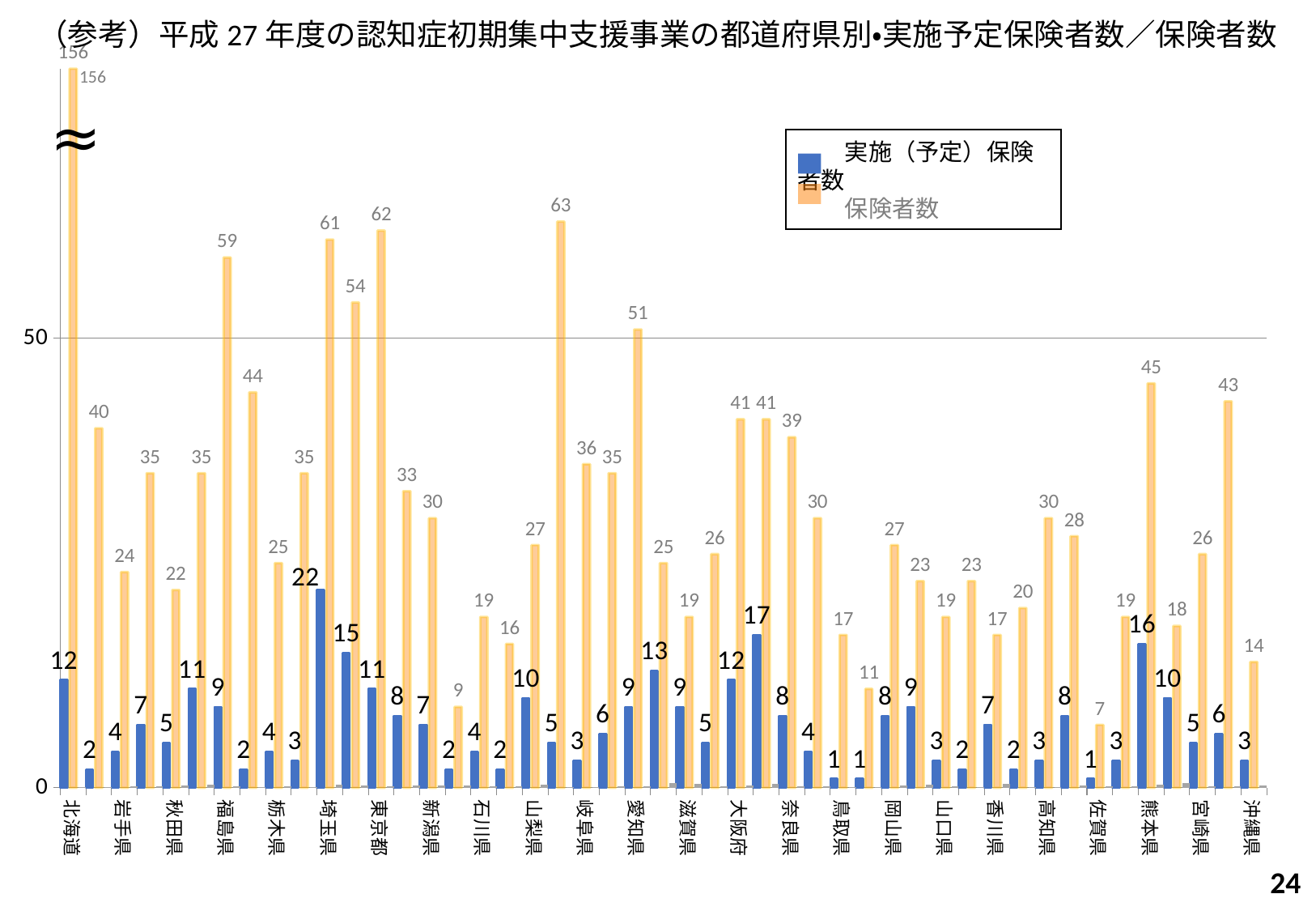
Which prefecture has the highest 実施（予定）保険者数? 埼玉県 Which has the larger 保険者数, 福島県 or 奈良県? 福島県 How many series does the legend list? 2 What kind of chart is shown on the slide? bar chart Which prefecture has the lowest 保険者数? 佐賀県 What is the 実施（予定）保険者数 value for 埼玉県? 22 What is the 保険者数 value for 東京都? 62 What is the 実施（予定）保険者数 value for 熊本県? 16 Is the 保険者数 value for 福島県 greater or less than 50? greater What is the 保険者数 value for 北海道? 156 What is the difference between 保険者数 and 実施（予定）保険者数 for 埼玉県? 39 Which prefecture has the highest 保険者数? 北海道